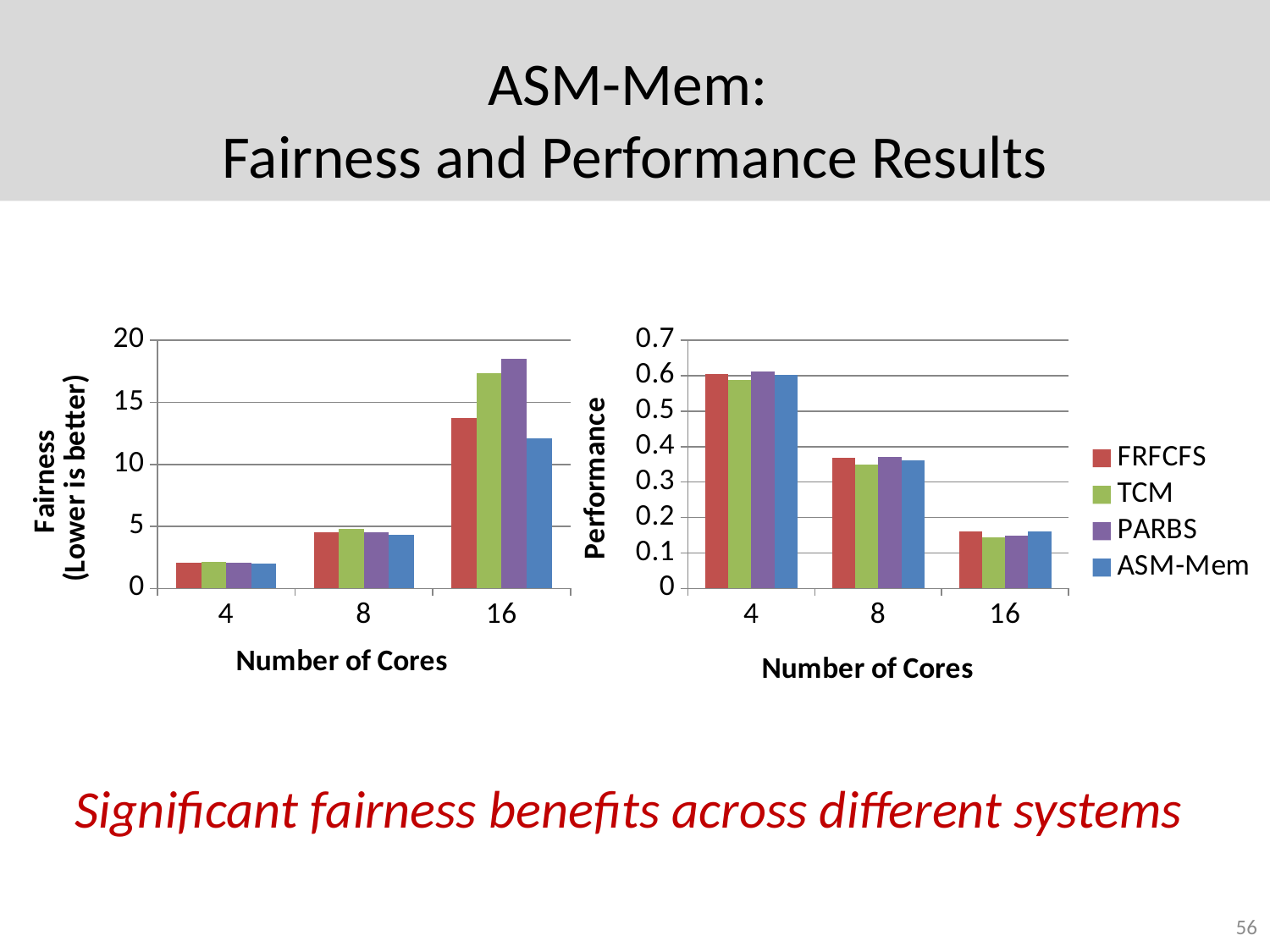
In the left chart (Fairness), which series has the highest value at 16 cores? PARBS What kind of chart is the left chart (Fairness)? bar chart In the right chart (Performance), do the values rise or fall as the number of cores increases? fall In the right chart (Performance), is the value for TCM at 16 cores greater or less than 0.2? less In the left chart (Fairness), is the value for FRFCFS at 16 cores greater or less than 15? less In the left chart (Fairness), is the value for ASM-Mem at 16 cores greater or less than 10? greater In the left chart (Fairness), how many Number of Cores categories are shown on the x axis? 3 In the left chart (Fairness), which series has the lowest value at 16 cores? ASM-Mem How many series does the legend list? 4 In the left chart (Fairness), do the values rise or fall as the number of cores increases? rise